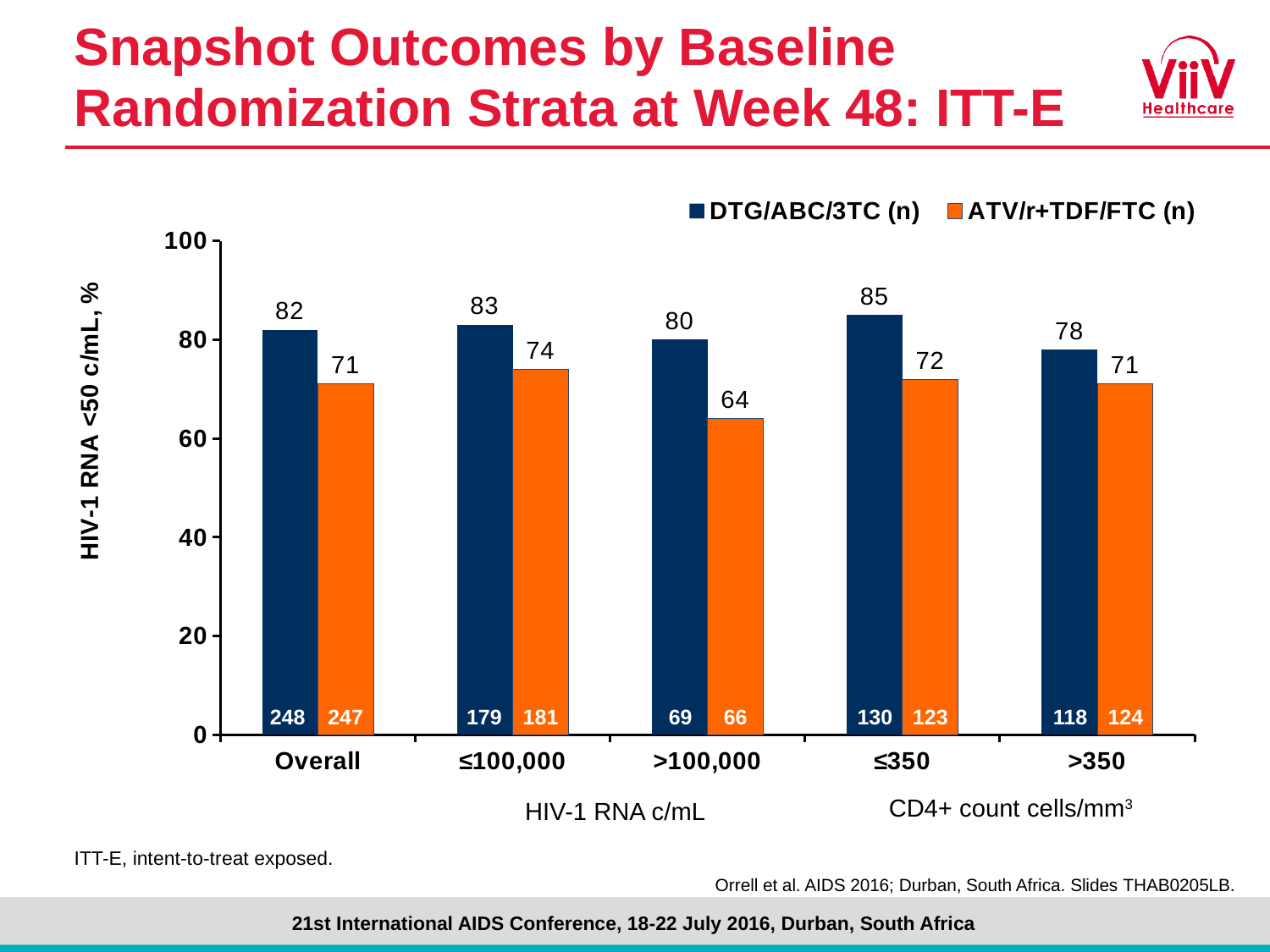
How many categories are shown on the x axis? 5 Which category has the highest value for DTG/ABC/3TC? ≤350 What is the n shown inside the DTG/ABC/3TC bar for the Overall category? 248 What is the value for ATV/r+TDF/FTC in the >100,000 HIV-1 RNA category? 64 What kind of chart is shown on the slide? Bar chart What is the y-axis label of the chart? HIV-1 RNA <50 c/mL, % Which series has the larger value in the >350 category, DTG/ABC/3TC or ATV/r+TDF/FTC? DTG/ABC/3TC What is the difference between the DTG/ABC/3TC and ATV/r+TDF/FTC values in the >100,000 category? 16 Which category has the lowest value for ATV/r+TDF/FTC? >100,000 How many series does the legend list? 2 What is the value for ATV/r+TDF/FTC in the ≤350 CD4+ count category? 72 What is the value for DTG/ABC/3TC in the Overall category? 82